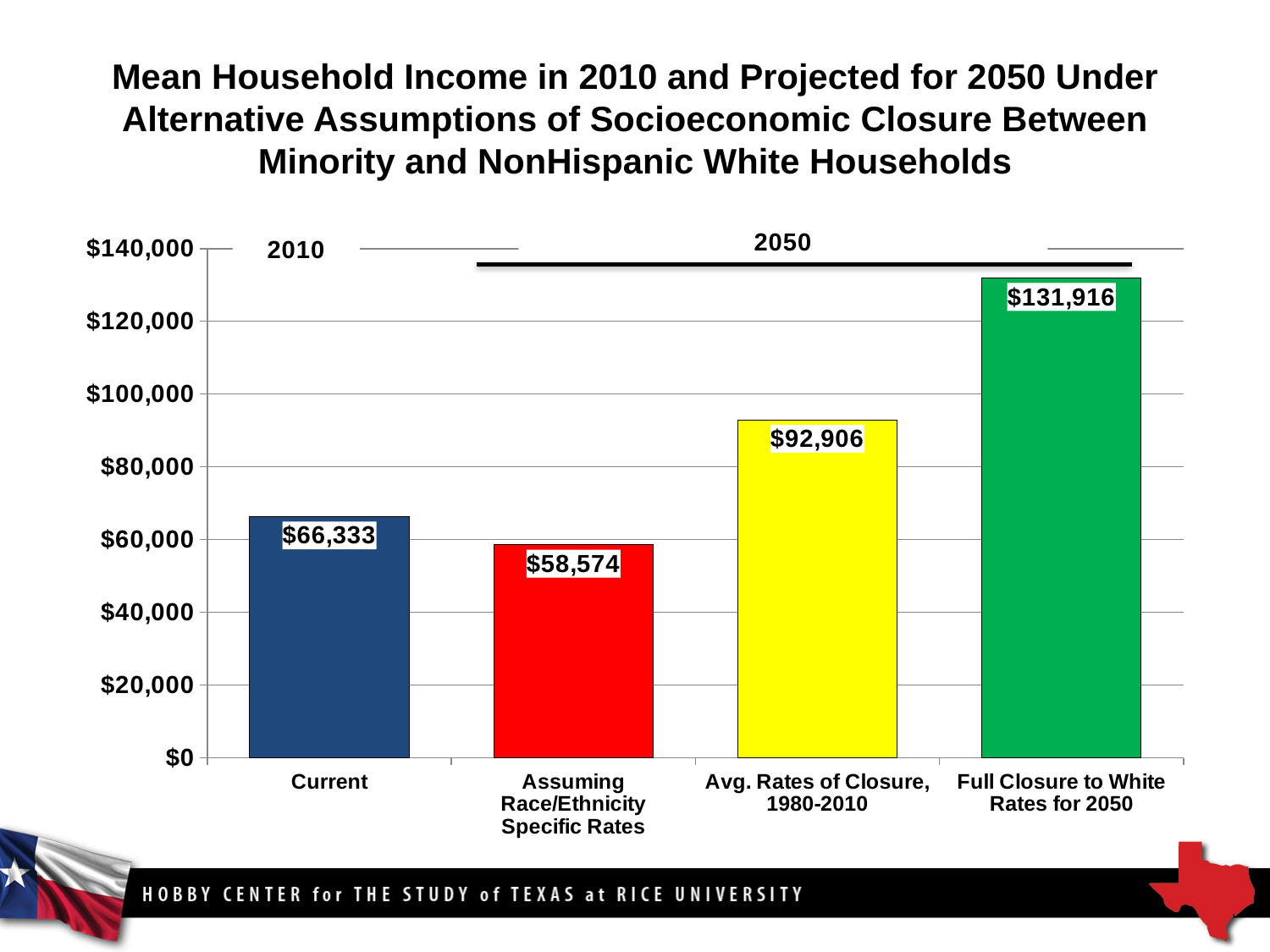
What is the difference between the Full Closure to White Rates for 2050 value and the Current value? $65,583 Which category has the highest mean household income? Full Closure to White Rates for 2050 What is the difference between the Current value and the Assuming Race/Ethnicity Specific Rates value? $7,759 Is the value for Avg. Rates of Closure, 1980-2010 greater or less than $100,000? less What is the projected mean household income for 2050 under Full Closure to White Rates for 2050? $131,916 What kind of chart is shown on the slide? bar chart Which category has the lowest mean household income? Assuming Race/Ethnicity Specific Rates How many categories are shown on the chart? 4 What is the projected mean household income for 2050 Assuming Race/Ethnicity Specific Rates? $58,574 What is the projected mean household income for 2050 under Avg. Rates of Closure, 1980-2010? $92,906 What is the mean household income for the Current (2010) category? $66,333 Which is larger, the value for Current or the value for Avg. Rates of Closure, 1980-2010? Avg. Rates of Closure, 1980-2010